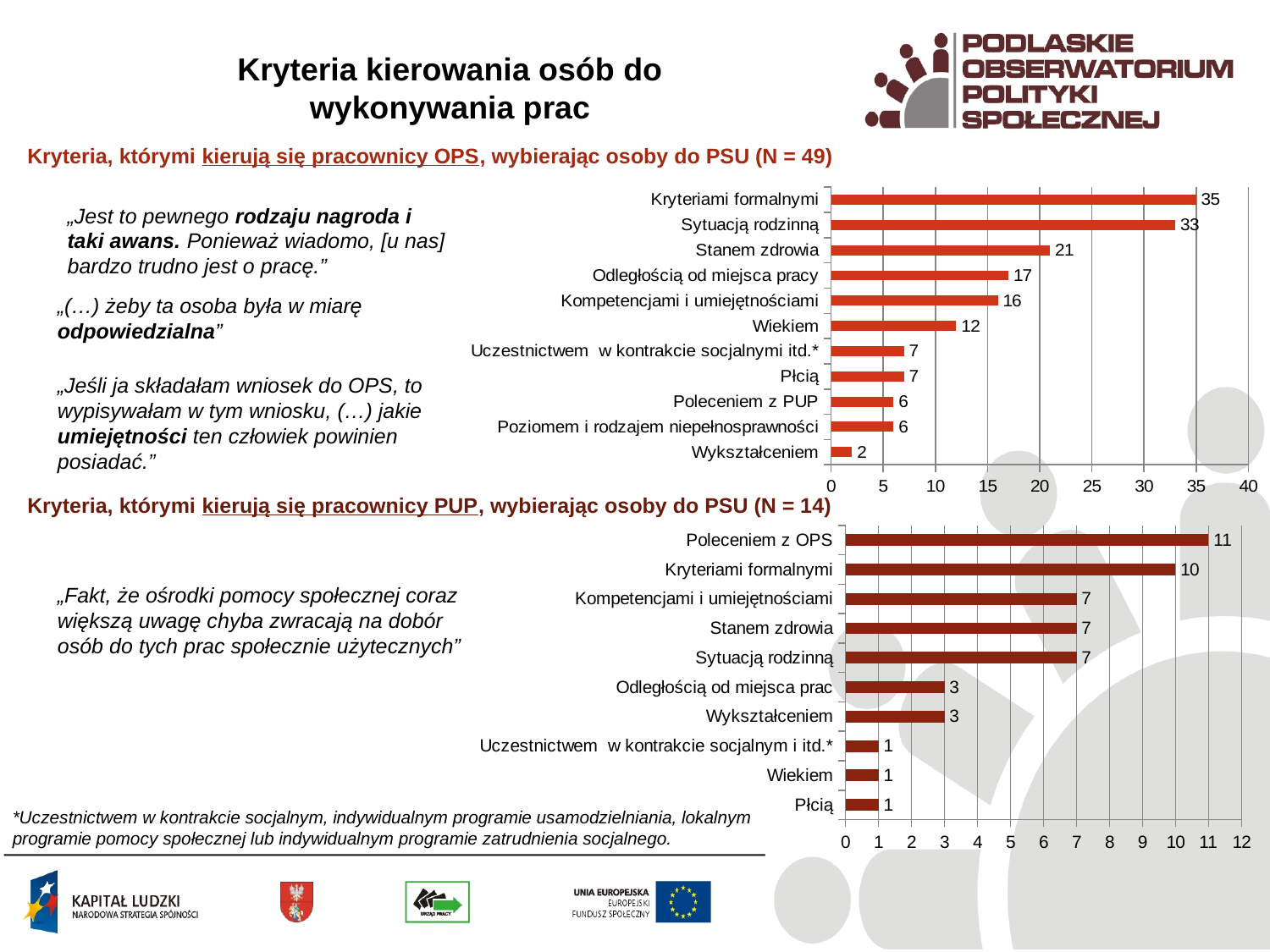
In the top chart (OPS workers, N = 49), which criterion has the lowest value? Wykształceniem In the bottom chart (PUP workers, N = 14), what is the value for "Wykształceniem"? 3 In the top chart (OPS workers, N = 49), what is the difference between "Kryteriami formalnymi" and "Sytuacją rodzinną"? 2 In the bottom chart (PUP workers, N = 14), what is the difference between "Kryteriami formalnymi" and "Kompetencjami i umiejętnościami"? 3 In the bottom chart (PUP workers, N = 14), how many criteria are listed? 10 In the top chart (OPS workers, N = 49), how many criteria are listed? 11 In the top chart (OPS workers, N = 49), which is larger: "Odległością od miejsca pracy" or "Wiekiem"? Odległością od miejsca pracy What type of chart is the top chart (OPS workers, N = 49)? Bar chart In the bottom chart (PUP workers, N = 14), what is the value for "Poleceniem z OPS"? 11 In the bottom chart (PUP workers, N = 14), which criterion has the highest value? Poleceniem z OPS In the top chart (OPS workers, N = 49), what is the value for "Stanem zdrowia"? 21 In the top chart (OPS workers, N = 49), what is the value for "Kryteriami formalnymi"? 35